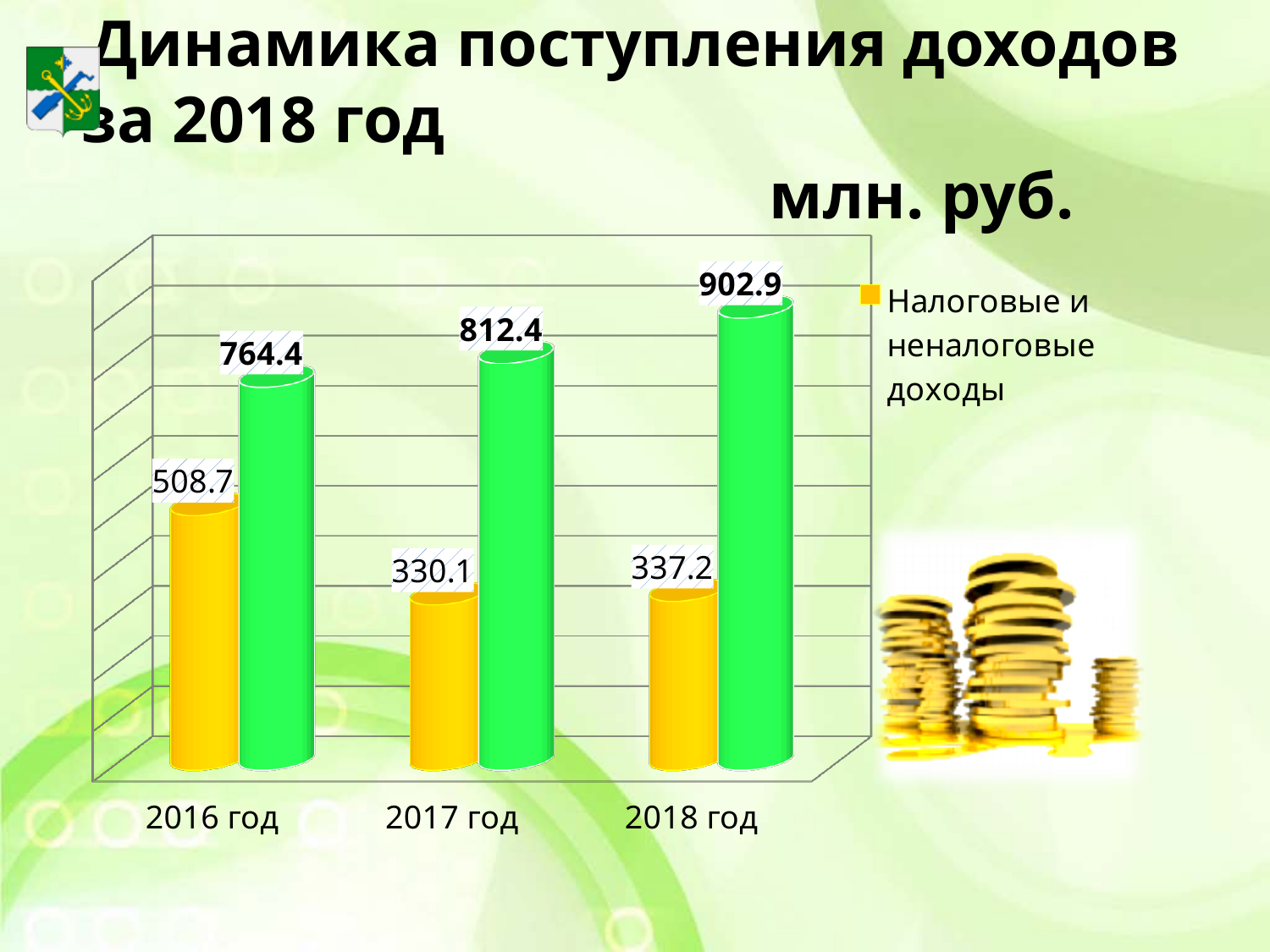
What is the unit of measurement stated above the chart? млн. руб. What type of chart is shown on the slide? Bar chart By how much does the green bar for 2018 год exceed the green bar for 2017 год? 90.5 Do the green bar values rise or fall from 2016 год to 2018 год? Rise What is the difference between the yellow bar values for 2016 год and 2017 год? 178.6 For 2016 год, which bar is larger, the yellow one or the green one? The green one (764.4) What is the value of the green bar for 2018 год? 902.9 In which year is the yellow bar (Налоговые и неналоговые доходы) the lowest? 2017 год How many years are shown on the x axis of the chart? 3 What is the value of the yellow bar (Налоговые и неналоговые доходы) for 2017 год? 330.1 What is the value of the yellow bar (Налоговые и неналоговые доходы) for 2016 год? 508.7 In which year is the green bar the highest? 2018 год